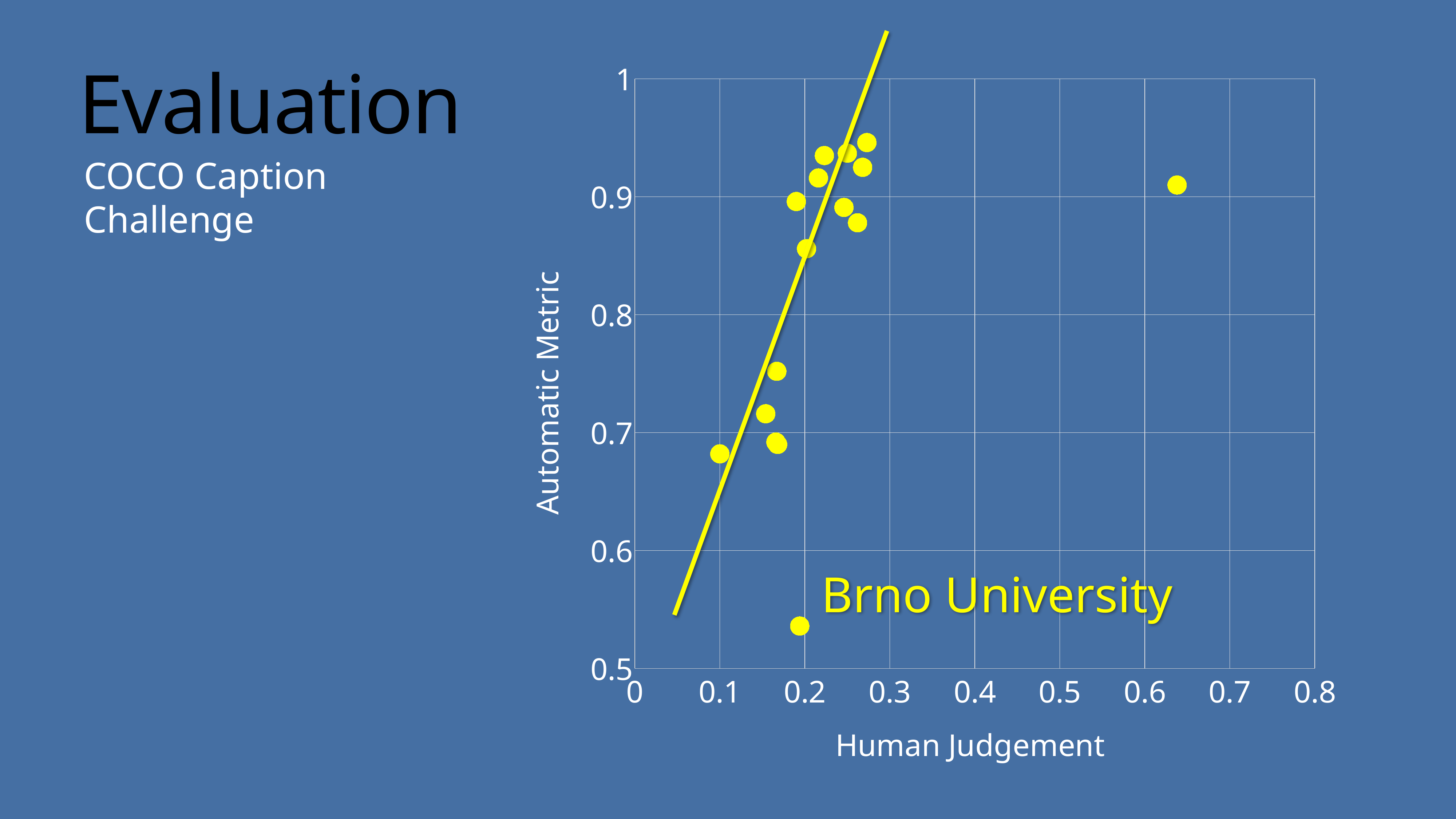
Is the Human Judgement value of the point labelled Brno University greater or less than 0.3? less What is the title of the y axis of the chart? Automatic Metric What is the maximum value shown on the y axis of the chart? 1 How many points have a Human Judgement value greater than 0.4? 1 What is the title of the x axis of the chart? Human Judgement What kind of chart is shown on the slide? scatter chart Does the trend line in the chart rise or fall as Human Judgement increases? rises Is the Automatic Metric value of the leftmost point greater or less than 0.7? less Is the Human Judgement value of the rightmost point greater or less than 0.5? greater Which has the higher Automatic Metric value: the point labelled Brno University or the rightmost point? the rightmost point Which point has the lowest Automatic Metric value? the point labelled Brno University